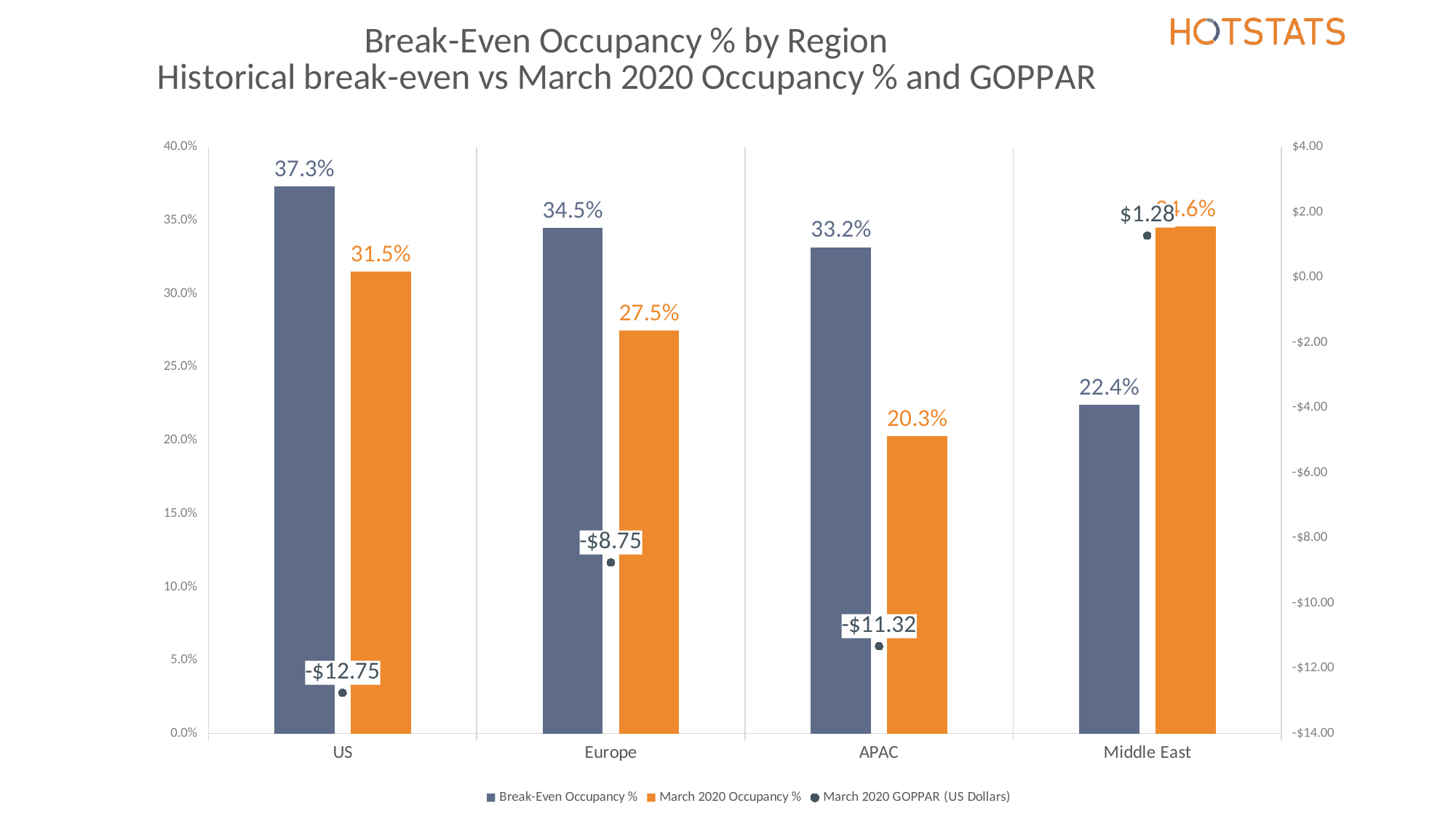
Which region has the highest Break-Even Occupancy %? US How many regions are shown on the x axis? 4 How many series does the legend list? 3 What is the difference between the Break-Even Occupancy % and the March 2020 Occupancy % for APAC? 12.9% Which region has the lowest March 2020 GOPPAR (US Dollars)? US What is the March 2020 GOPPAR (US Dollars) for the Middle East? $1.28 Which is larger for Europe: the Break-Even Occupancy % or the March 2020 Occupancy %? Break-Even Occupancy % Is the Break-Even Occupancy % for the Middle East greater or less than 25.0%? less What is the March 2020 GOPPAR (US Dollars) for APAC? -$11.32 What is the Break-Even Occupancy % for the US? 37.3% What kind of chart is used to show the occupancy percentages? Bar chart What is the March 2020 Occupancy % for Europe? 27.5%